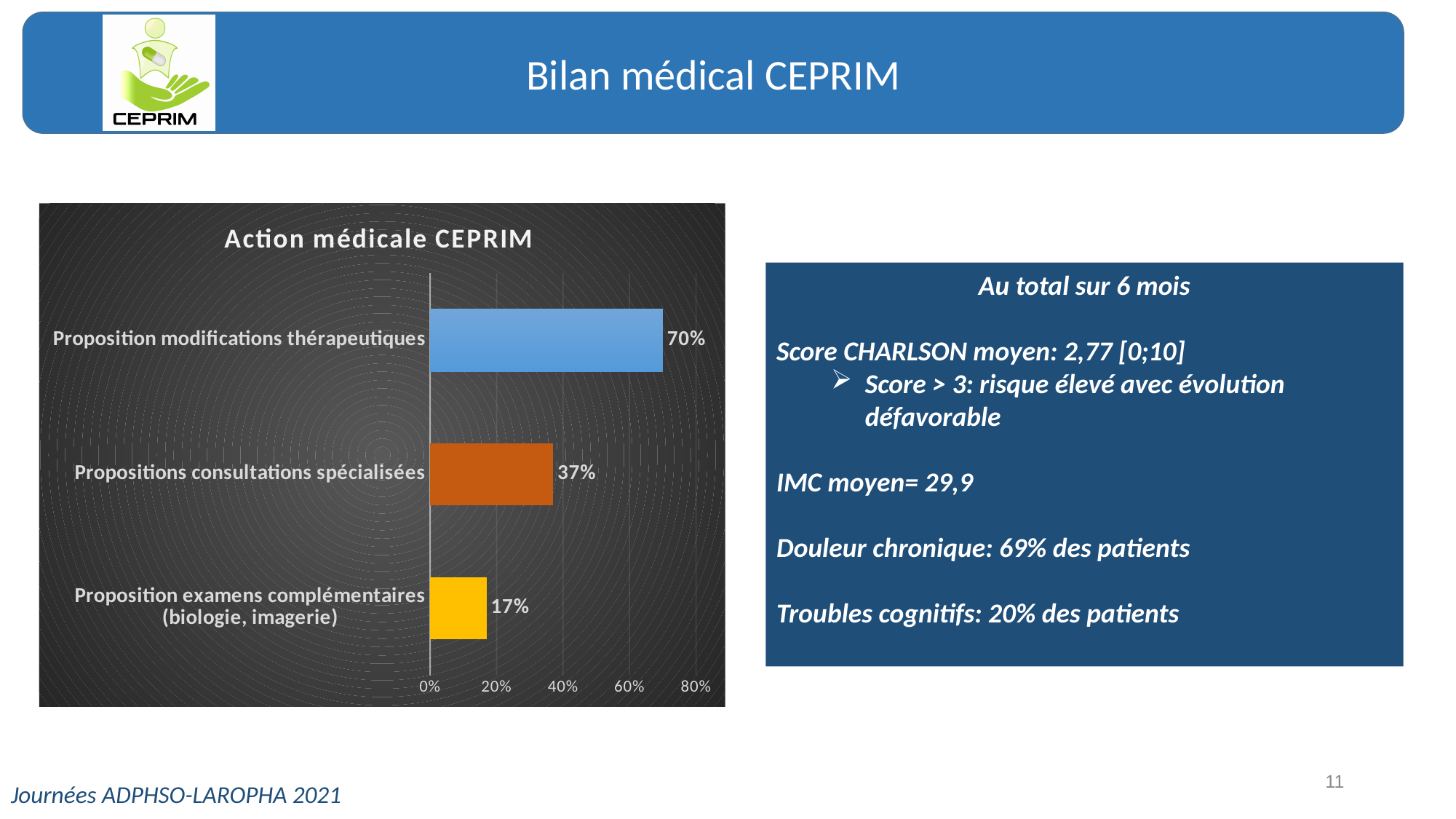
Which is larger: the value for Propositions consultations spécialisées or for Proposition examens complémentaires (biologie, imagerie)? Propositions consultations spécialisées How many categories are shown in the chart? 3 What is the value for Proposition examens complémentaires (biologie, imagerie)? 17% What is the value for Proposition modifications thérapeutiques? 70% Which category has the highest value? Proposition modifications thérapeutiques What is the value for Propositions consultations spécialisées? 37% What is the title of the chart? Action médicale CEPRIM What is the difference between the values for Proposition modifications thérapeutiques and Propositions consultations spécialisées? 33% Is the value for Proposition modifications thérapeutiques greater or less than 60%? greater Which category has the lowest value? Proposition examens complémentaires (biologie, imagerie) What kind of chart is shown on the slide? Bar chart What is the difference between the values for Propositions consultations spécialisées and Proposition examens complémentaires (biologie, imagerie)? 20%